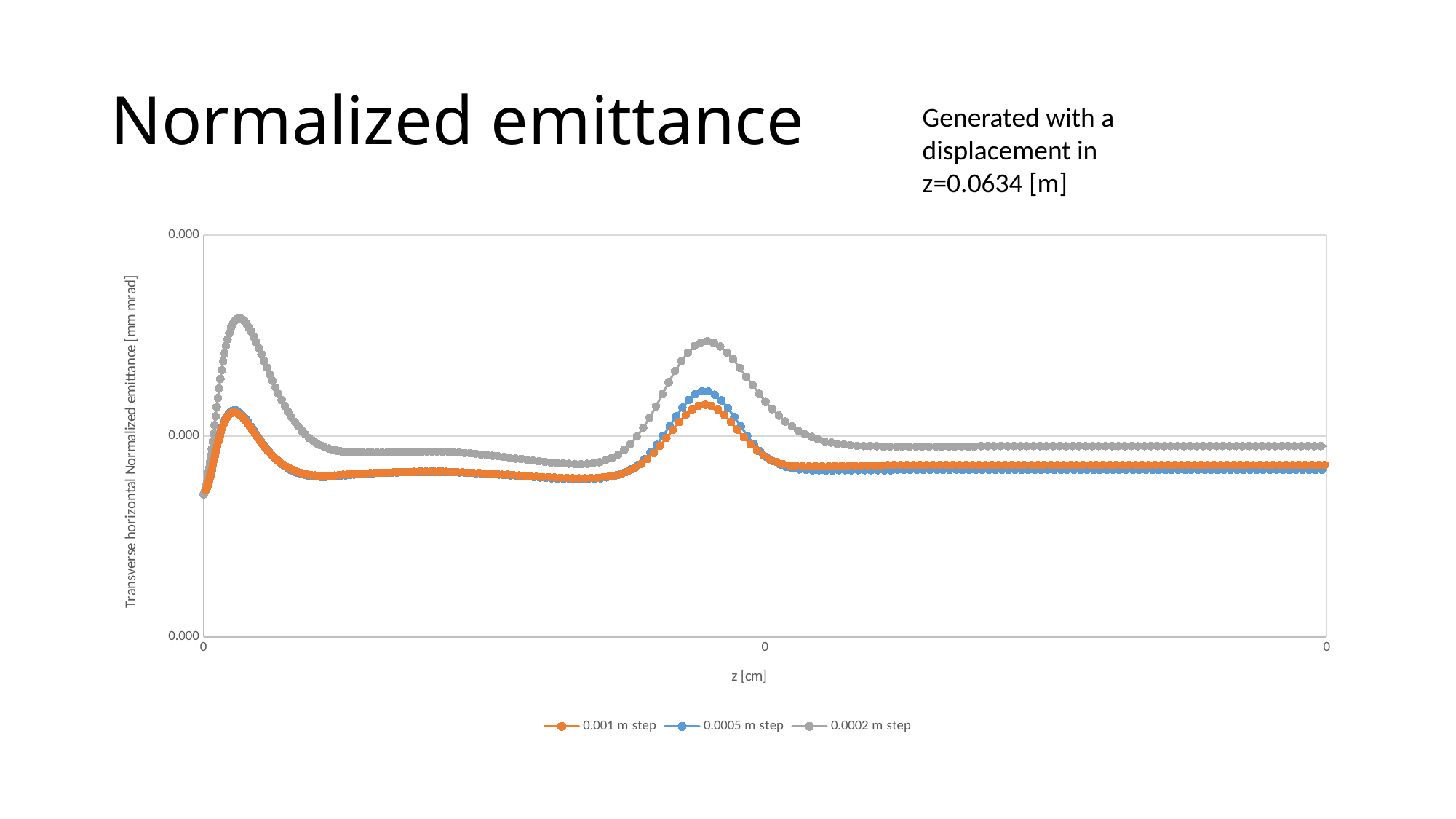
What kind of chart is shown on the slide? line chart Starting from the left edge of the chart, do the values initially rise or fall? rise At the first peak, which series is higher: 0.0002 m step or 0.0005 m step? 0.0002 m step Immediately after the second peak, do the values rise or fall as z increases? fall What is the title of the x axis? z [cm] At the second peak, which series is higher: 0.0002 m step or 0.001 m step? 0.0002 m step How many series does the legend list? 3 How many peaks does the 0.0002 m step series show? 2 Which series has the highest values at the right-hand end of the chart? 0.0002 m step Which series reaches the highest peak on the chart? 0.0002 m step What are the names of the series listed in the legend? 0.001 m step, 0.0005 m step, 0.0002 m step